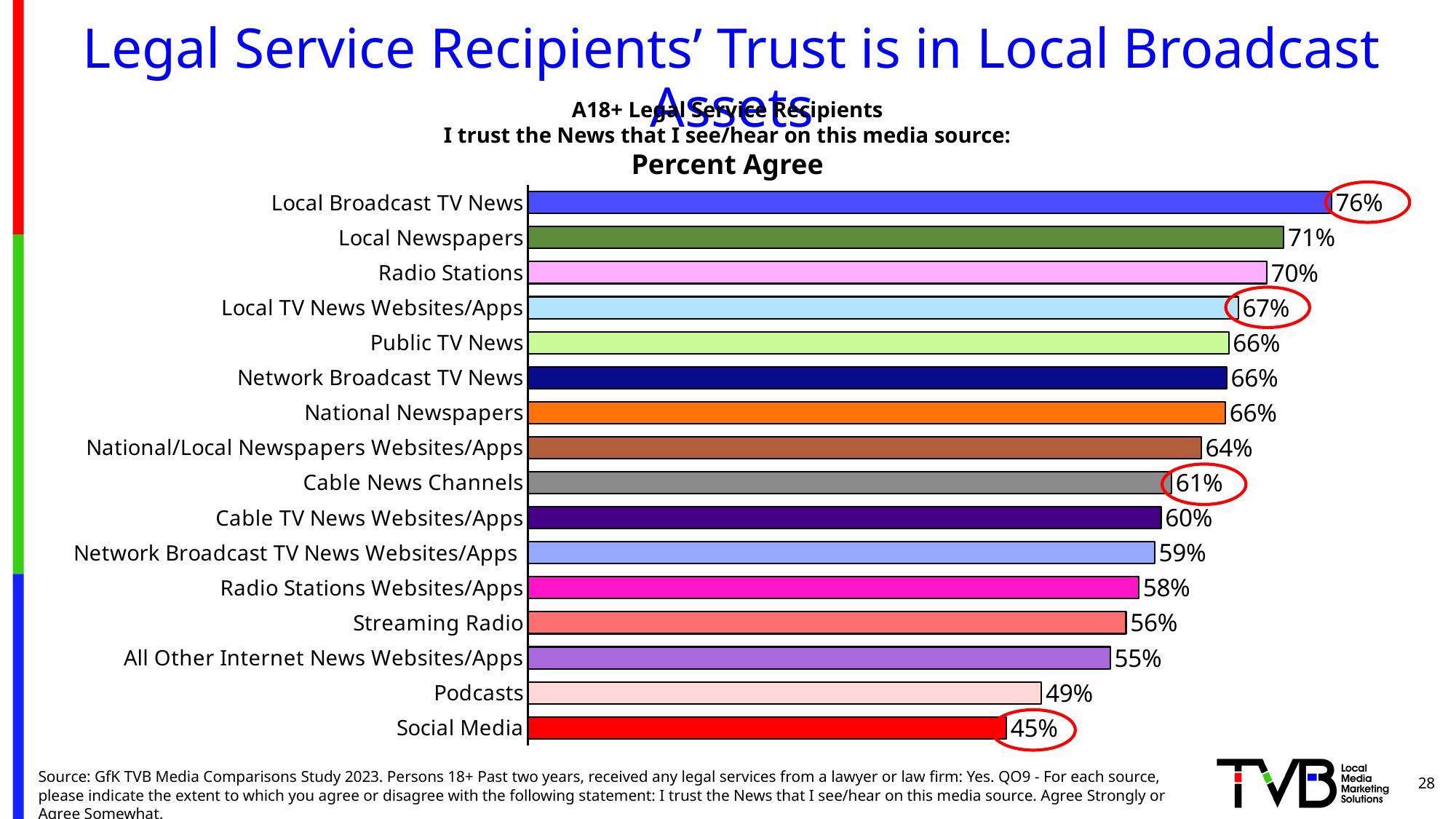
How many media sources are shown in the chart? 16 What is the difference in percent agree between Local Newspapers and Radio Stations? 1% What is the percent agree value for Cable News Channels? 61% What is the percent agree value for Social Media? 45% How many values on the chart are circled in red? 4 What is the difference in percent agree between Local Broadcast TV News and Social Media? 31% Which media source has the lowest percent agree? Social Media What percent of legal service recipients agree they trust the news on Local Broadcast TV News? 76% What kind of chart is shown on the slide? Bar chart What is the percent agree value for Podcasts? 49% Which has a higher percent agree, Streaming Radio or Podcasts? Streaming Radio Which media source has the highest percent agree? Local Broadcast TV News